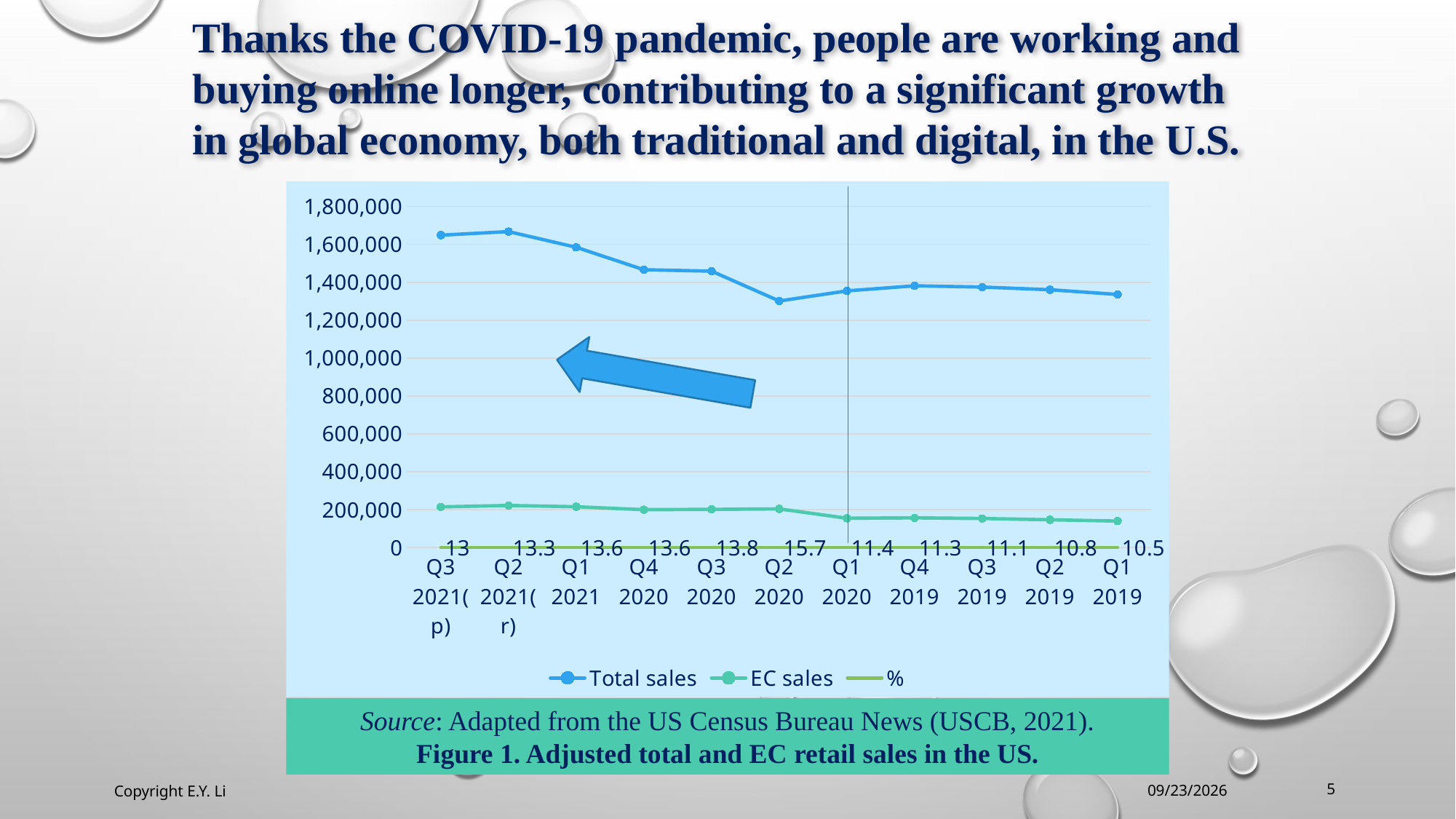
Which has the larger % value, Q3 2021(p) or Q2 2021(r)? Q2 2021(r) What is the difference between the % values for Q2 2020 and Q1 2020? 4.3 How many quarters are plotted along the x axis of the chart? 11 In which quarter is the % series lowest? Q1 2019 What type of chart is shown on the slide? Line chart Is the Total sales value for Q3 2021(p) greater or less than 1,600,000? greater What is the % value for Q3 2021(p)? 13 What is the % value for Q2 2020? 15.7 What is the figure caption given below the chart? Figure 1. Adjusted total and EC retail sales in the US. In which quarter is the % series highest? Q2 2020 How many series does the chart legend list? 3 Is the EC sales value for Q1 2019 greater or less than 200,000? less